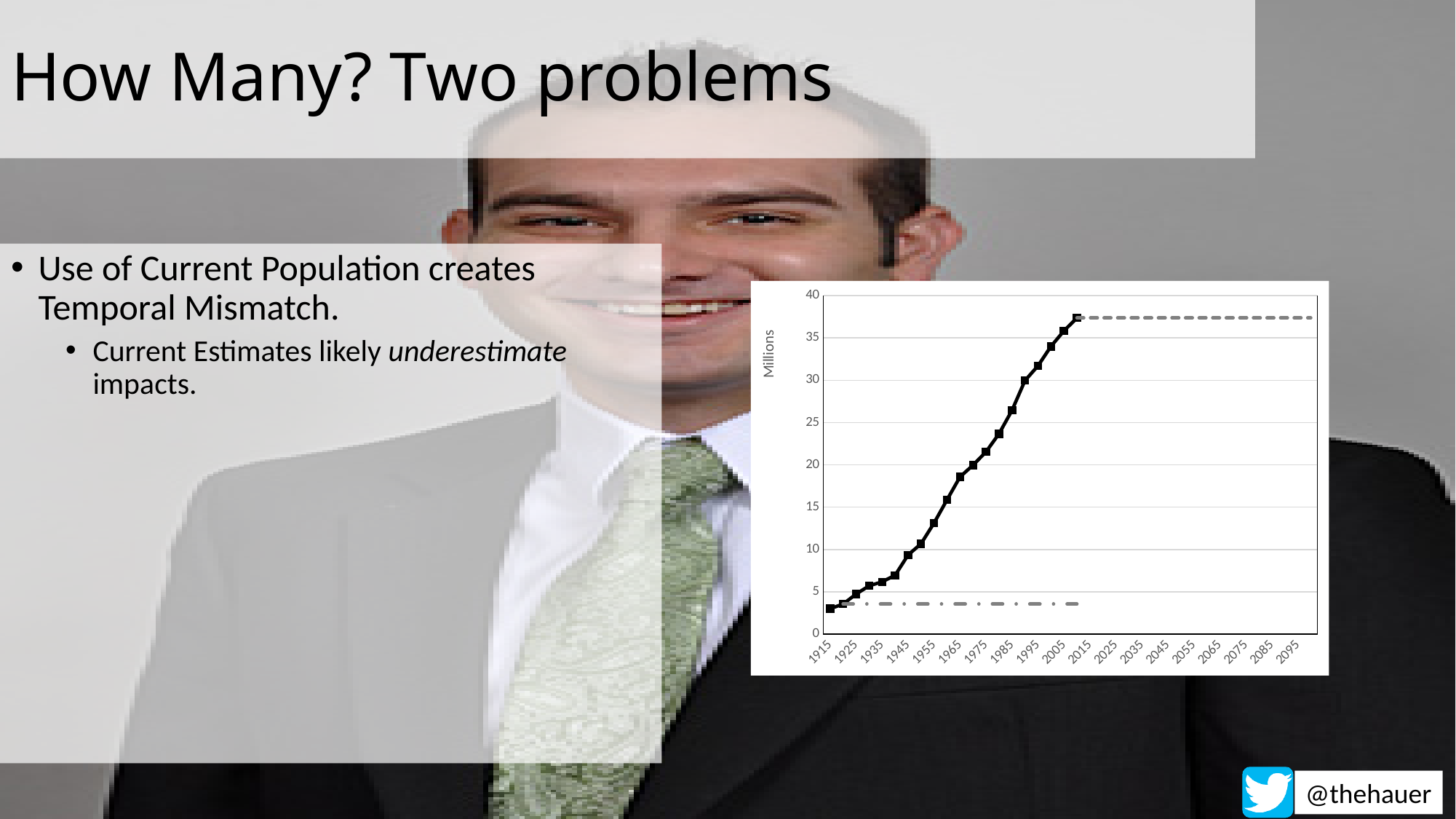
What is the label on the vertical axis of the chart? Millions Does the plotted line rise or fall from 1915 to 2015? rise Is the value for 1995 greater or less than 25? greater Is the value for 1915 greater or less than 5? less What kind of chart is shown on the slide? line chart What is the highest value shown on the vertical axis? 40 Is the value for 1965 greater or less than 15? greater How many year labels are shown on the horizontal axis? 19 In which year does the solid line reach its highest value? 2010 Which year has the larger value, 1915 or 2015? 2015